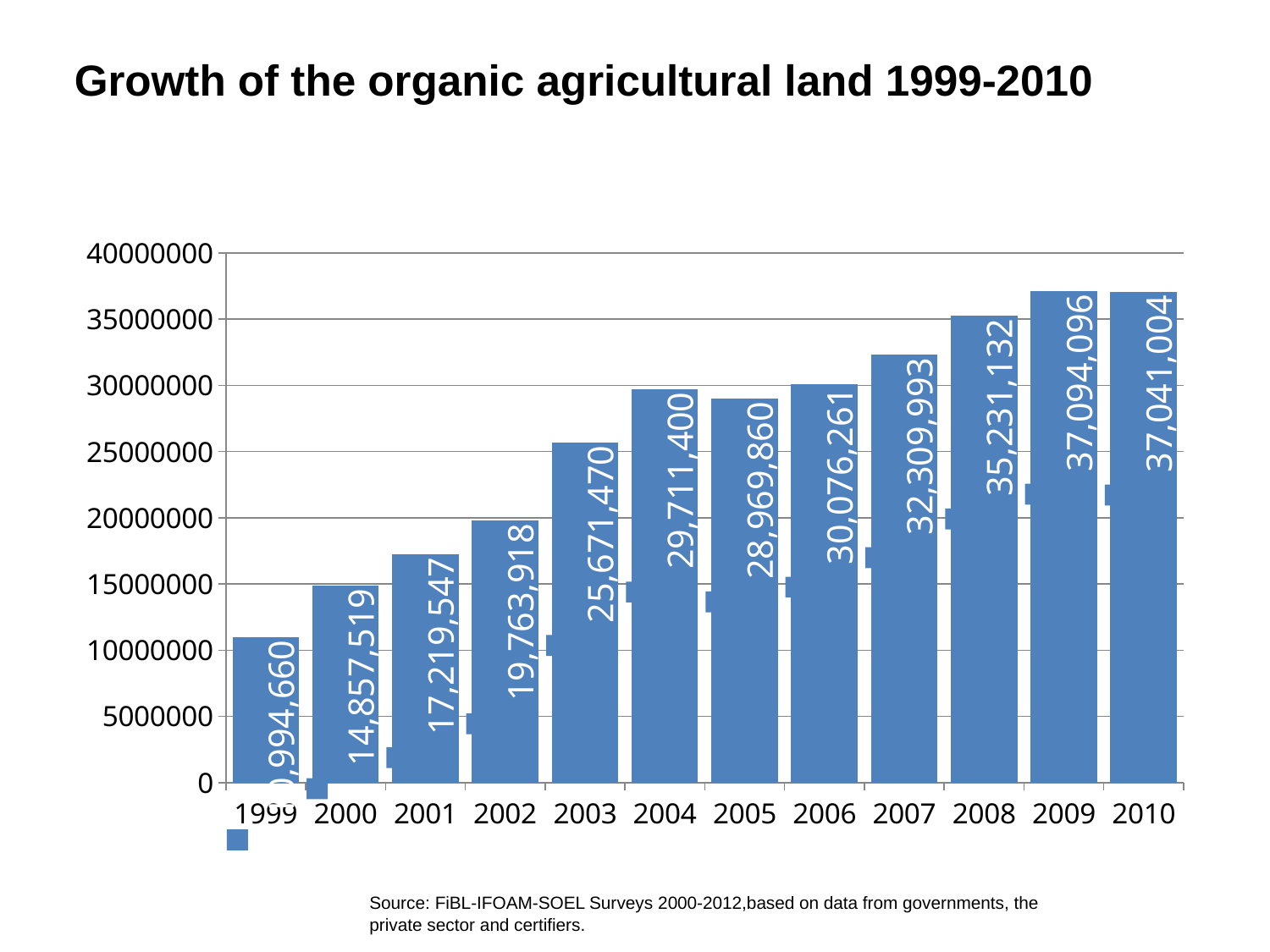
What kind of chart is shown on the slide? bar chart What is the difference between the values for 2008 and 2007? 2,921,139 Which year has the lowest value? 1999 What is the value for 2008? 35,231,132 Which is larger, the value for 2004 or the value for 2005? 2004 Which year has the highest value? 2009 What is the value for 2005? 28,969,860 What is the value for 2000? 14,857,519 How many years are shown on the x axis? 12 Is the value for 1999 greater or less than 15000000? less What is the value for 2010? 37,041,004 What is the title of the chart? Growth of the organic agricultural land 1999-2010